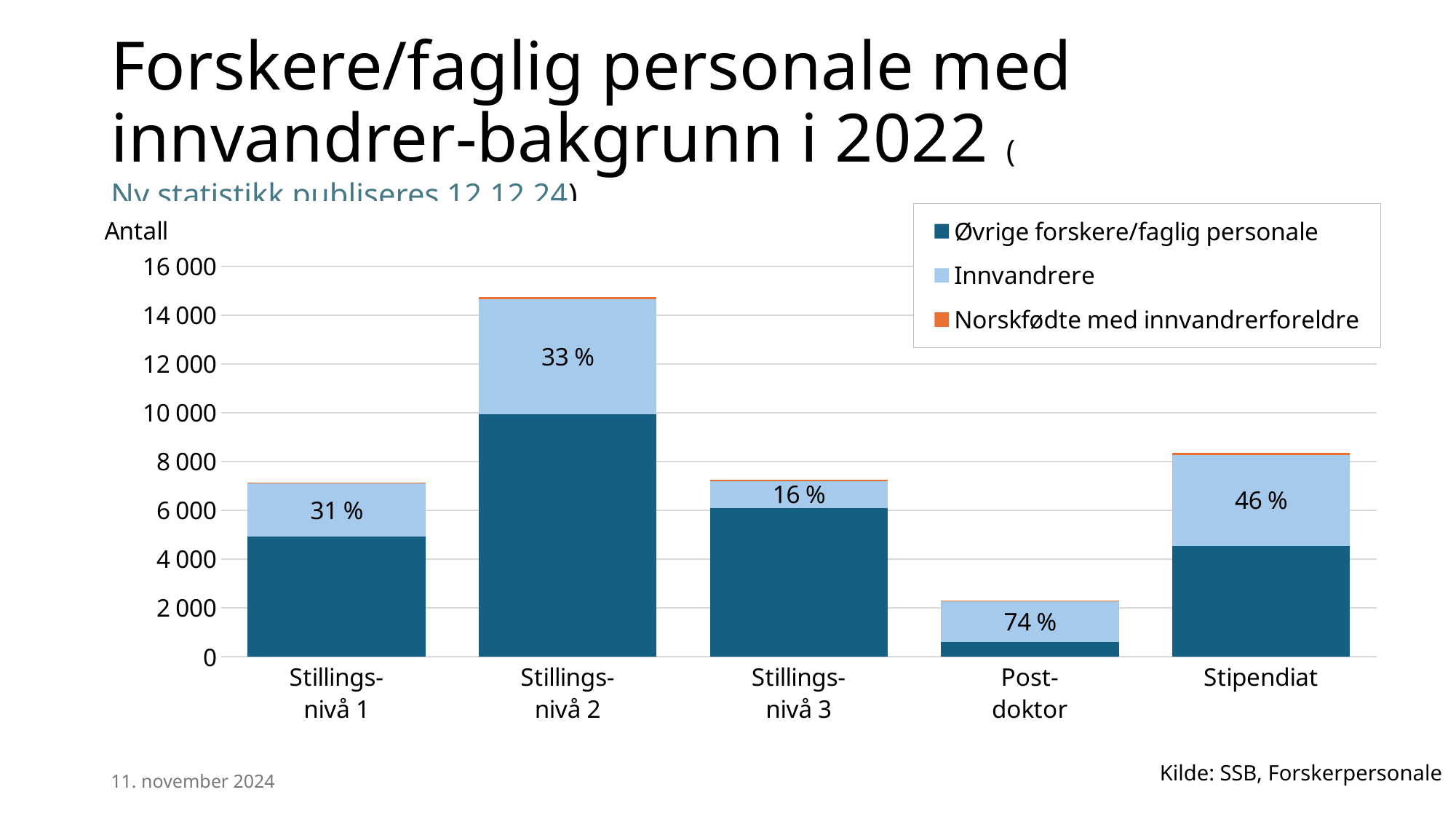
Which category has the shortest total bar? Post-doktor How many categories are shown on the x axis? 5 What is the difference in percentage points between the labels for Post-doktor and Stillingsnivå 3? 58 What percentage label is shown on the bar for Stipendiat? 46 % How many series does the legend list? 3 Is the total bar for Stillingsnivå 2 greater or less than 14 000? greater What percentage label is shown on the bar for Stillingsnivå 1? 31 % Is the total bar for Post-doktor greater or less than 4 000? less Which category has the highest percentage label on its bar? Post-doktor Which category has the tallest total bar? Stillingsnivå 2 What percentage label is shown on the bar for Post-doktor? 74 % Which category has the lowest percentage label on its bar? Stillingsnivå 3